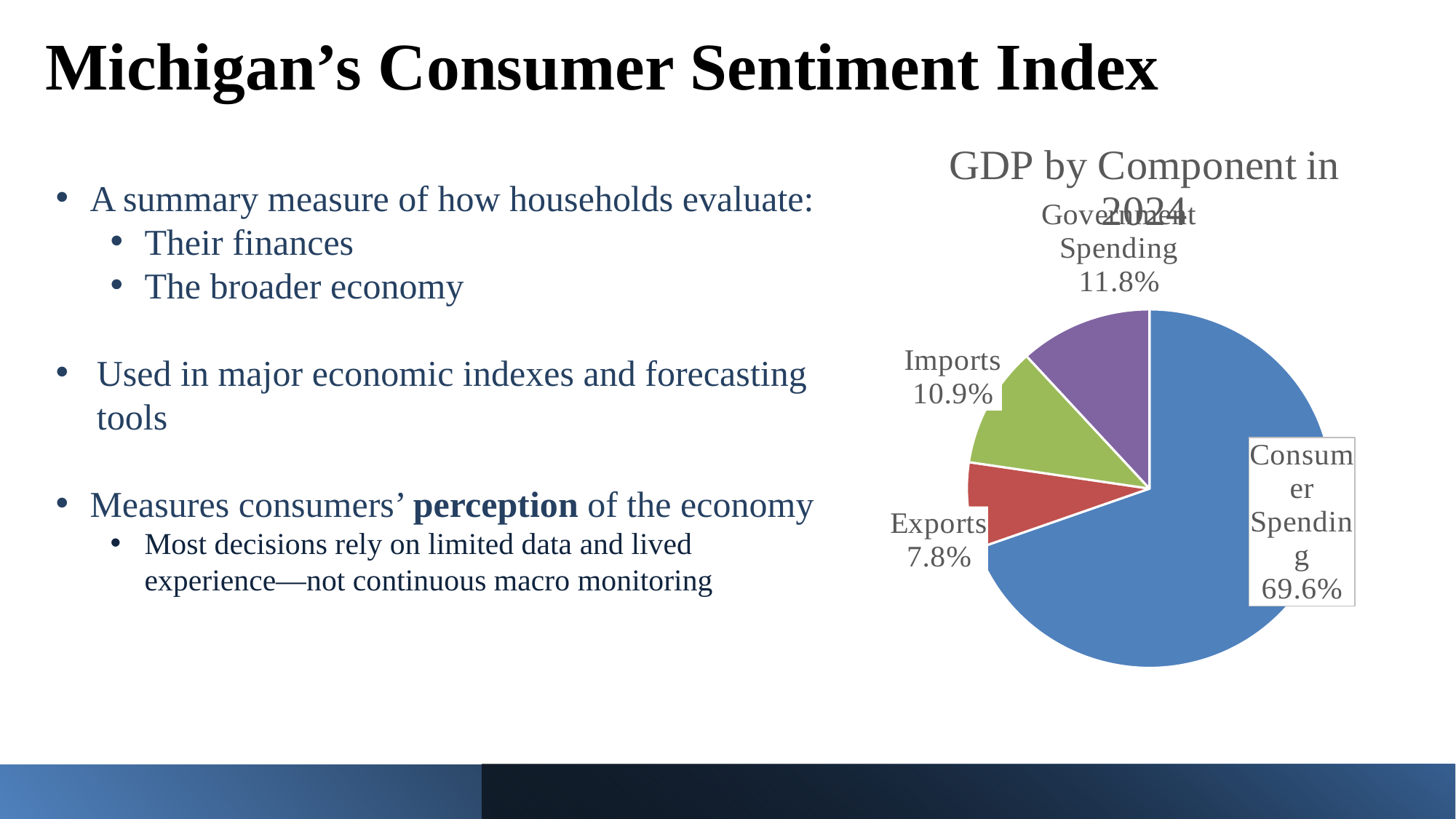
What kind of chart is shown on the slide? pie chart What share of the pie does Exports take? 7.8% Which component has the largest slice of the pie? Consumer Spending What share of the pie does Government Spending take? 11.8% What colour is the Consumer Spending slice? blue Which is larger, the Imports slice or the Exports slice? Imports What share of the pie does Imports take? 10.9% Which component has the smallest slice of the pie? Exports What is the difference in percentage points between Government Spending and Exports? 4.0 percentage points How many slices does the pie chart have? 4 What is the title of the chart on the slide? GDP by Component in 2024